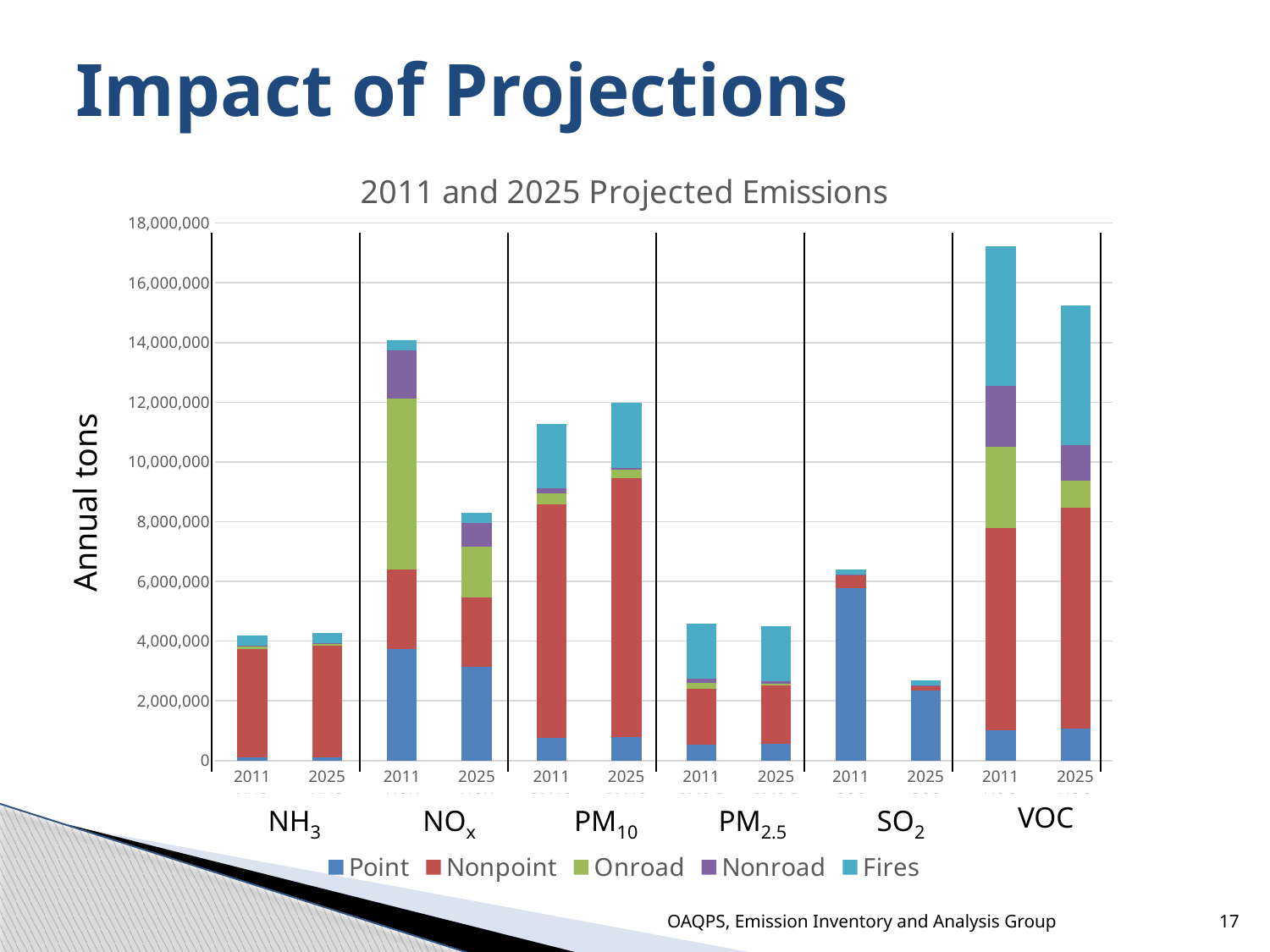
Is the total for VOC in 2011 greater or less than 16,000,000 annual tons? greater Which bar has the lowest total emissions? SO2 2025 For SO2, which year has the larger total emissions, 2011 or 2025? 2011 Which bar has the highest total emissions? VOC 2011 Is the total for NOx in 2011 greater or less than 12,000,000 annual tons? greater What type of chart is shown on the slide? Stacked bar chart For NOx, which year has the larger total emissions, 2011 or 2025? 2011 How many bars are plotted in the chart? 12 Is the total for SO2 in 2025 greater or less than 4,000,000 annual tons? less What is the title of the chart? 2011 and 2025 Projected Emissions How many series does the legend list? 5 How many pollutant groups are shown along the x axis? 6